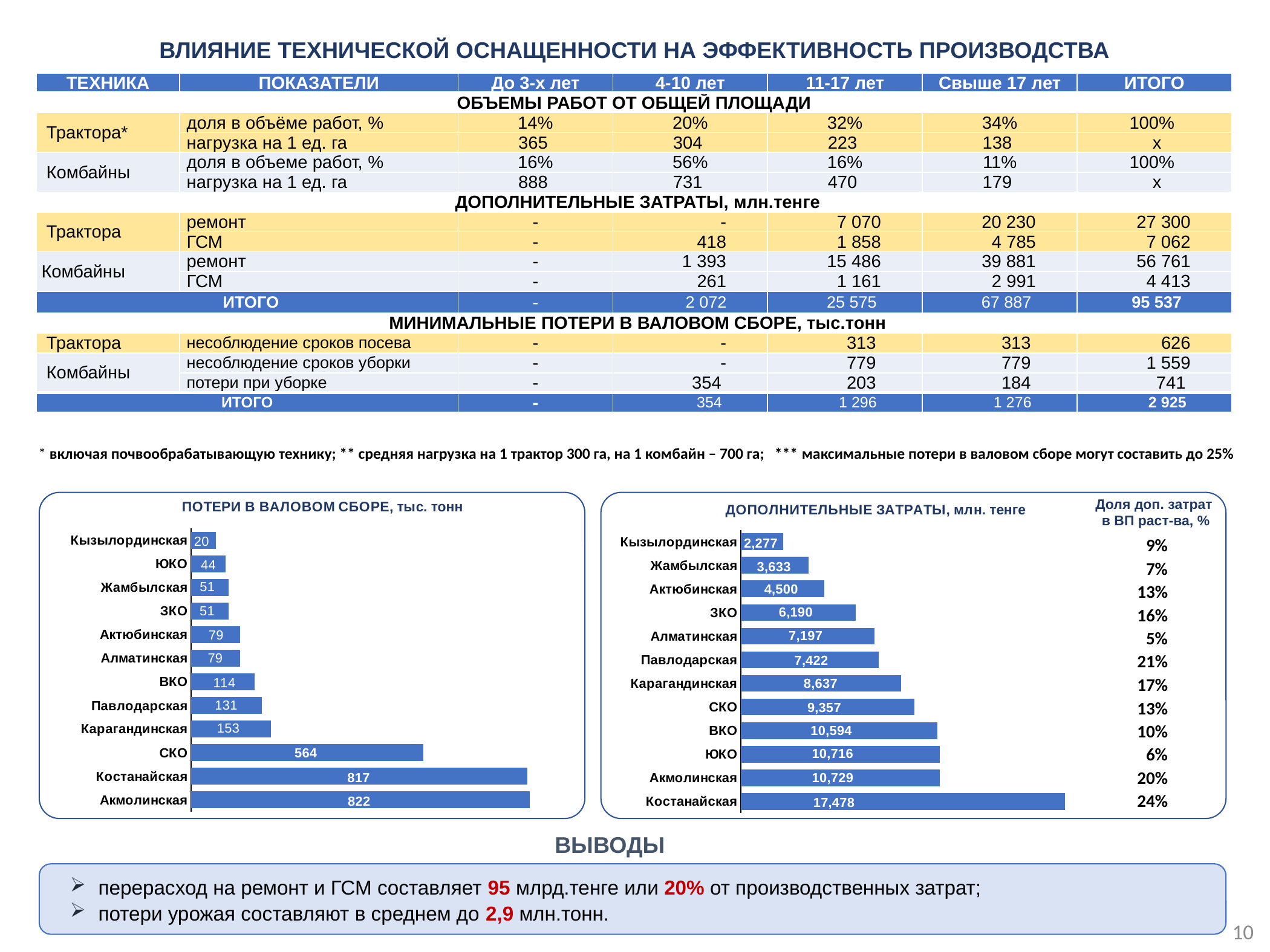
In the chart titled "ДОПОЛНИТЕЛЬНЫЕ ЗАТРАТЫ, млн. тенге", which region has the highest value? Костанайская What kind of chart is the one titled "ДОПОЛНИТЕЛЬНЫЕ ЗАТРАТЫ, млн. тенге"? bar chart In the chart titled "ПОТЕРИ В ВАЛОВОМ СБОРЕ, тыс. тонн", how many regions are shown? 12 In the chart titled "ПОТЕРИ В ВАЛОВОМ СБОРЕ, тыс. тонн", which is larger, Павлодарская or ВКО? Павлодарская In the chart titled "ПОТЕРИ В ВАЛОВОМ СБОРЕ, тыс. тонн", which region has the lowest value? Кызылординская In the chart titled "ДОПОЛНИТЕЛЬНЫЕ ЗАТРАТЫ, млн. тенге", what percentage is shown next to Павлодарская in the column "Доля доп. затрат в ВП раст-ва, %"? 21% In the chart titled "ПОТЕРИ В ВАЛОВОМ СБОРЕ, тыс. тонн", what is the difference between Костанайская and Карагандинская? 664 In the chart titled "ДОПОЛНИТЕЛЬНЫЕ ЗАТРАТЫ, млн. тенге", what is the value for ЗКО? 6,190 In the chart titled "ДОПОЛНИТЕЛЬНЫЕ ЗАТРАТЫ, млн. тенге", what is the difference between Костанайская and Акмолинская? 6,749 In the chart titled "ПОТЕРИ В ВАЛОВОМ СБОРЕ, тыс. тонн", what is the value for СКО? 564 In the chart titled "ДОПОЛНИТЕЛЬНЫЕ ЗАТРАТЫ, млн. тенге", what is the value for Карагандинская? 8,637 In the chart titled "ДОПОЛНИТЕЛЬНЫЕ ЗАТРАТЫ, млн. тенге", which is larger, Актюбинская or Жамбылская? Актюбинская